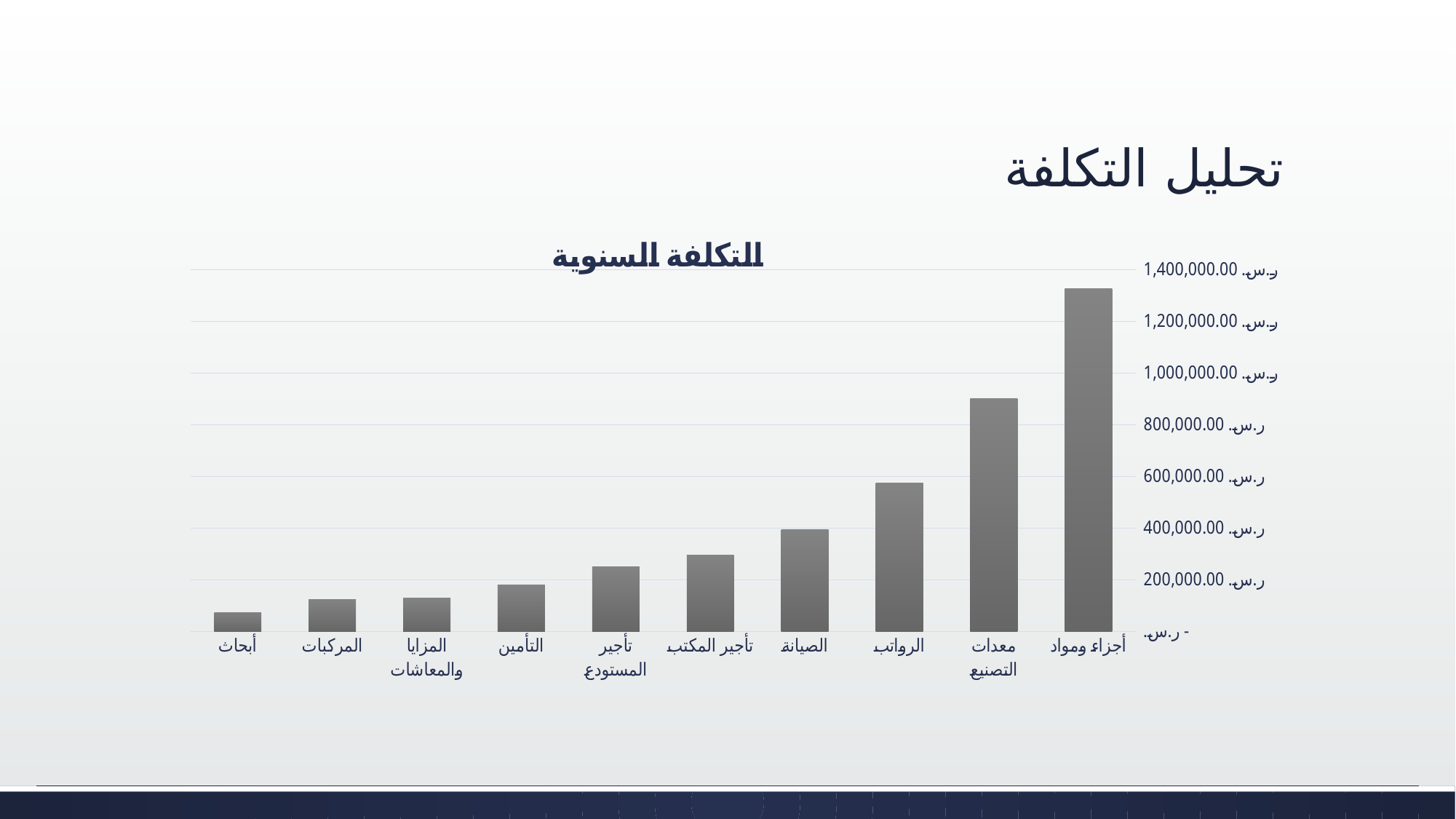
What is the title of the chart? التكلفة السنوية Is the value for معدات التصنيع greater or less than 1,000,000.00? less Which category has the lowest annual cost? أبحاث Is the value for أجزاء ومواد greater or less than 1,200,000.00? greater Is the value for معدات التصنيع greater or less than 800,000.00? greater Which category has the highest annual cost? أجزاء ومواد What kind of chart is shown on the slide? bar chart Which has a larger annual cost, الرواتب or الصيانة? الرواتب How many categories are plotted in the chart? 10 Do the bar values rise or fall moving from left to right along the x axis? rise